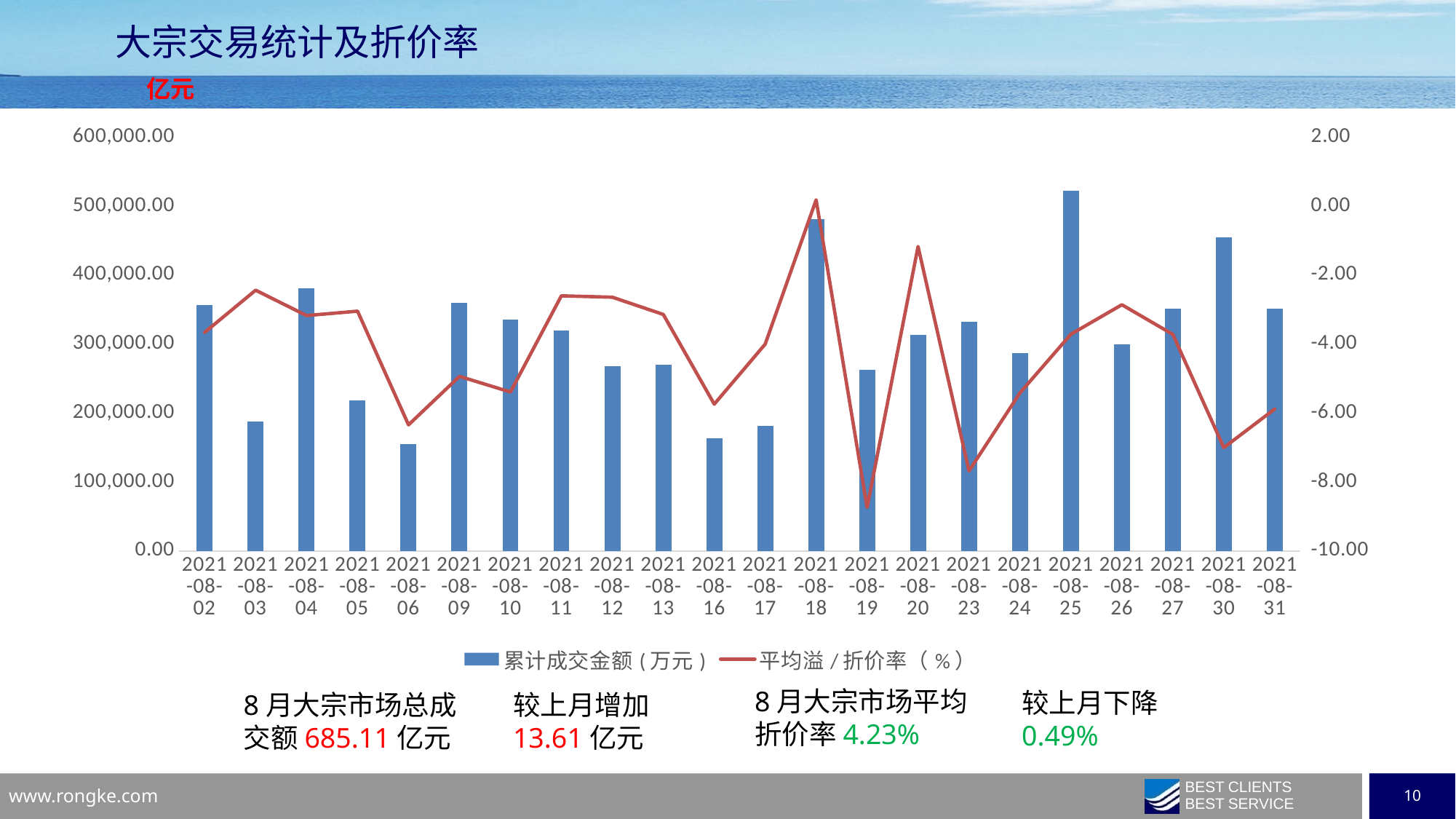
Is the 平均溢/折价率 value for 2021-08-19 greater or less than -8.00? less How many series does the legend list? 2 Is the 累计成交金额 bar for 2021-08-25 greater or less than 500,000.00? greater Which date has the larger 累计成交金额 bar, 2021-08-03 or 2021-08-04? 2021-08-04 On which date does the 平均溢/折价率 line reach its highest point? 2021-08-18 Which date has the larger 累计成交金额 bar, 2021-08-30 or 2021-08-31? 2021-08-30 On which date does the 平均溢/折价率 line reach its lowest point? 2021-08-19 Is the 累计成交金额 bar for 2021-08-06 greater or less than 200,000.00? less On which date is the bar for 累计成交金额 the highest? 2021-08-25 How many dates are shown along the x axis? 22 What kind of chart is shown on the slide? Combination bar and line chart What is the legend label of the line series? 平均溢/折价率（%）